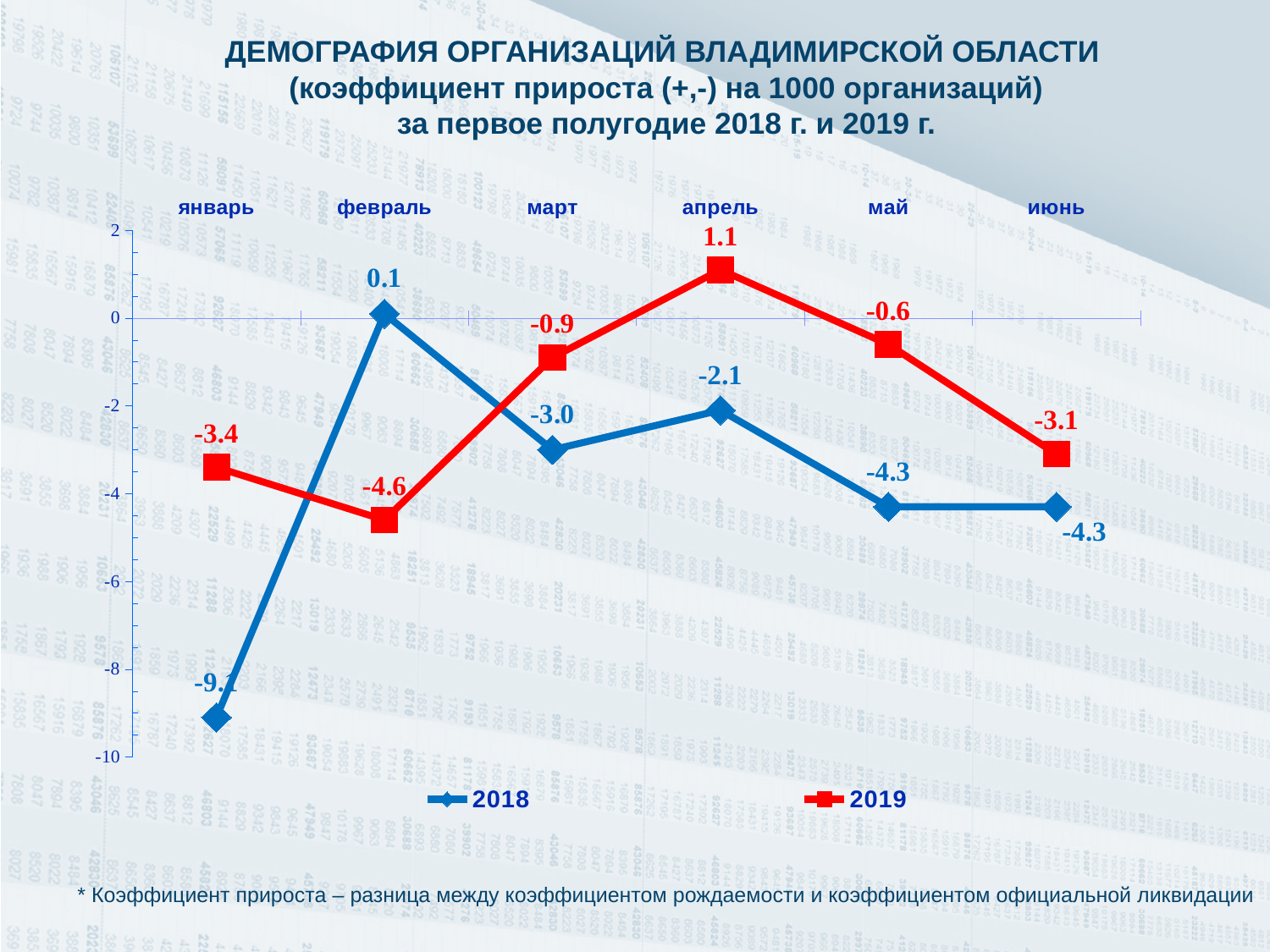
What is the value for 2019 in апрель? 1.1 How many months are shown on the x axis? 6 What is the value for 2018 in февраль? 0.1 In which month does the 2019 series reach its highest value? апрель In which month does the 2019 series have its lowest value? февраль What is the difference between the 2018 values for апрель and март? 0.9 How many series does the legend list? 2 What kind of chart is shown on the slide? line chart In which month does the 2018 series have its lowest value? январь What is the value for 2019 in июнь? -3.1 Which series has the larger value in март, 2018 or 2019? 2019 Is the value for 2018 in январь greater or less than -8? less